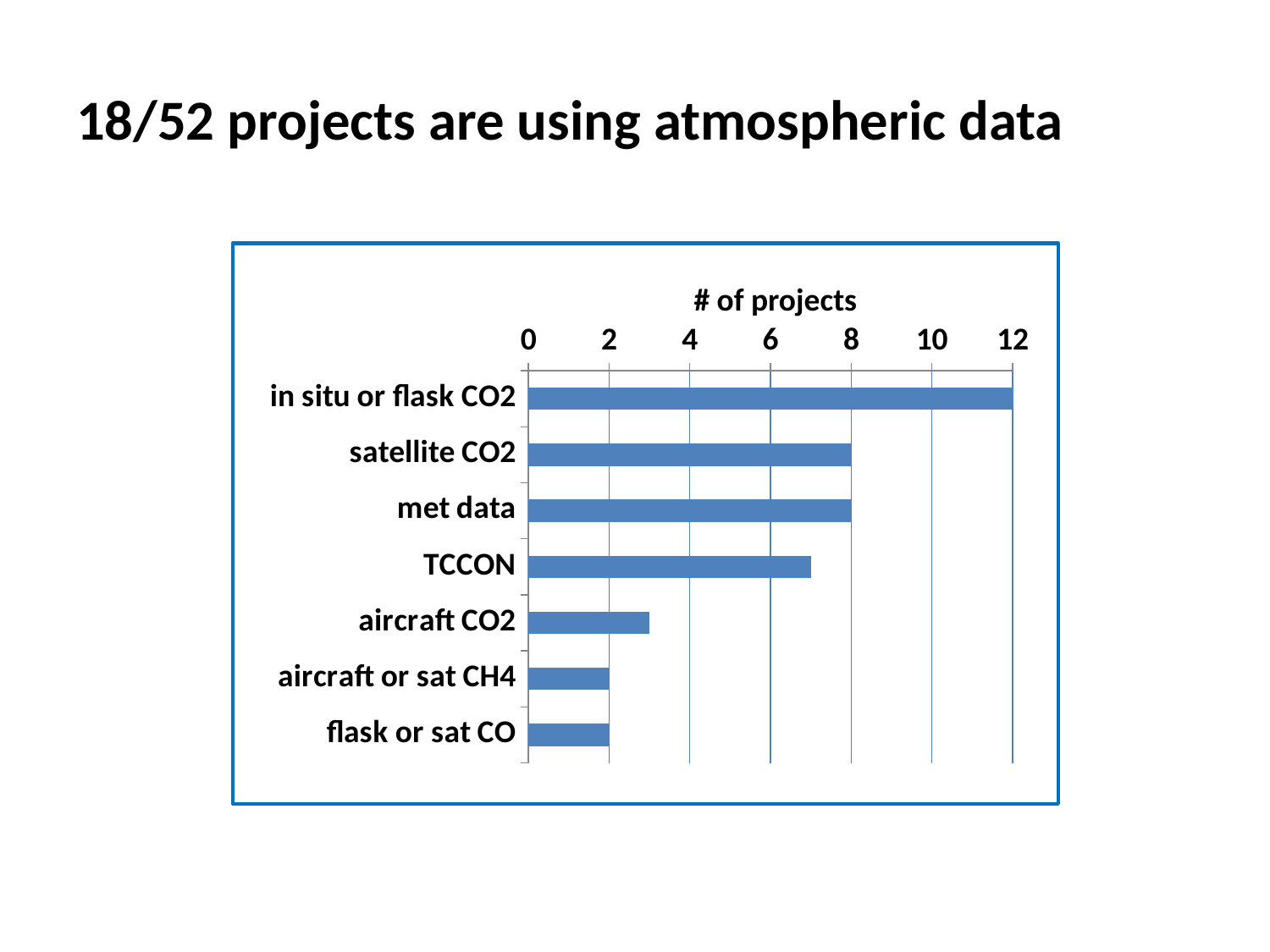
What kind of chart is shown on the slide? bar chart Is the value for TCCON greater or less than 6? greater Which category has the highest number of projects? in situ or flask CO2 What is the title of the value axis in the chart? # of projects How many categories are plotted in the chart? 7 How many projects use in situ or flask CO2? 12 How many projects use aircraft or sat CH4? 2 How many projects use satellite CO2? 8 Is the value for aircraft CO2 greater or less than 4? less What is the difference in number of projects between in situ or flask CO2 and satellite CO2? 4 How many projects use met data? 8 Which has more projects, satellite CO2 or TCCON? satellite CO2